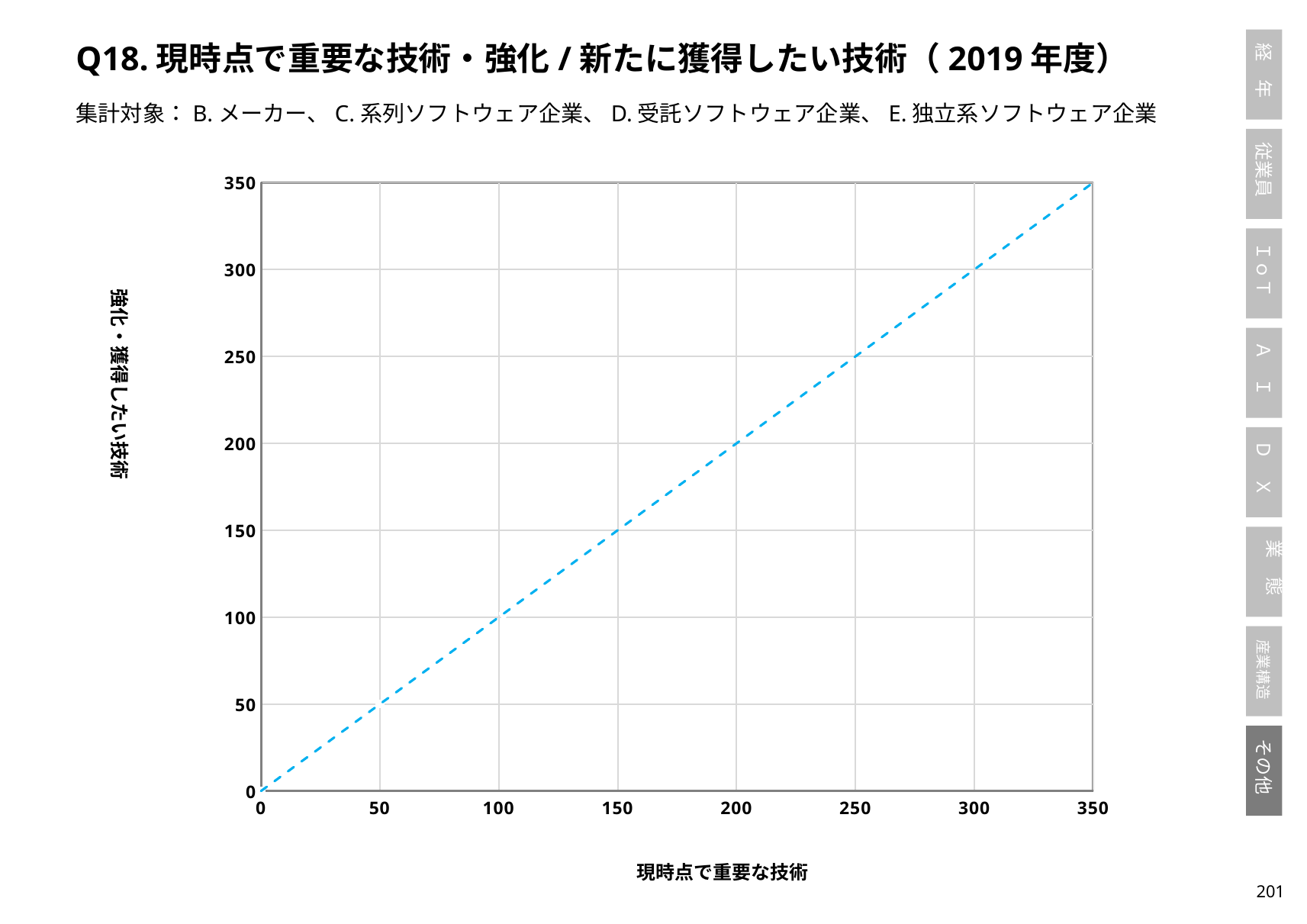
What is the interval between consecutive tick labels on the vertical axis? 50 Does the dashed line rise or fall as the x axis increases? rise What is the highest value shown on the horizontal axis? 350 Is the y value of the dashed line at x = 100 greater or less than 150? less What is the label of the horizontal axis? 現時点で重要な技術 What y value does the dashed line pass through at x = 200? 200 At what x value does the dashed line start? 0 What is the highest value shown on the vertical axis? 350 What y value does the dashed line reach at x = 350? 350 Is the y value of the dashed line at x = 300 greater or less than 250? greater What is the title of the chart on the slide? Q18. 現時点で重要な技術・強化 / 新たに獲得したい技術（2019 年度）